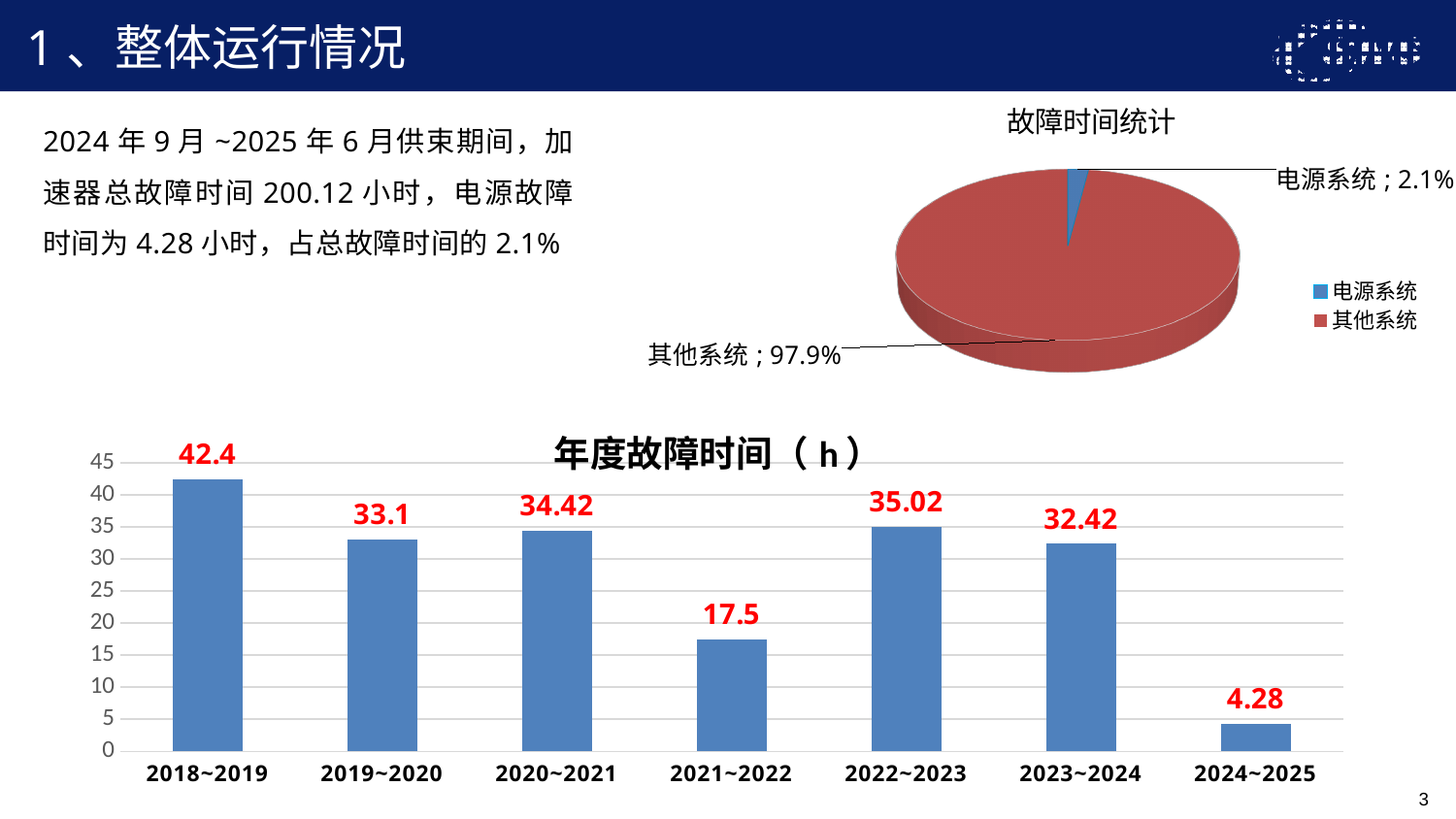
In the 故障时间统计 pie chart, what share does 其他系统 have? 97.9% In the 故障时间统计 pie chart, what share does 电源系统 have? 2.1% In the 年度故障时间（h） chart, which is larger, 2019~2020 or 2020~2021? 2020~2021 In the 年度故障时间（h） chart, how many periods are shown? 7 In the 故障时间统计 pie chart, what colour is the 其他系统 slice? Red In the 年度故障时间（h） chart, what is the value for 2021~2022? 17.5 In the 年度故障时间（h） chart, which period has the lowest value? 2024~2025 In the 故障时间统计 pie chart, how many entries does the legend list? 2 What kind of chart is the 年度故障时间（h） chart? Bar chart In the 年度故障时间（h） chart, what is the difference between 2022~2023 and 2023~2024? 2.6 In the 年度故障时间（h） chart, which period has the highest value? 2018~2019 In the 年度故障时间（h） chart, what is the value for 2018~2019? 42.4